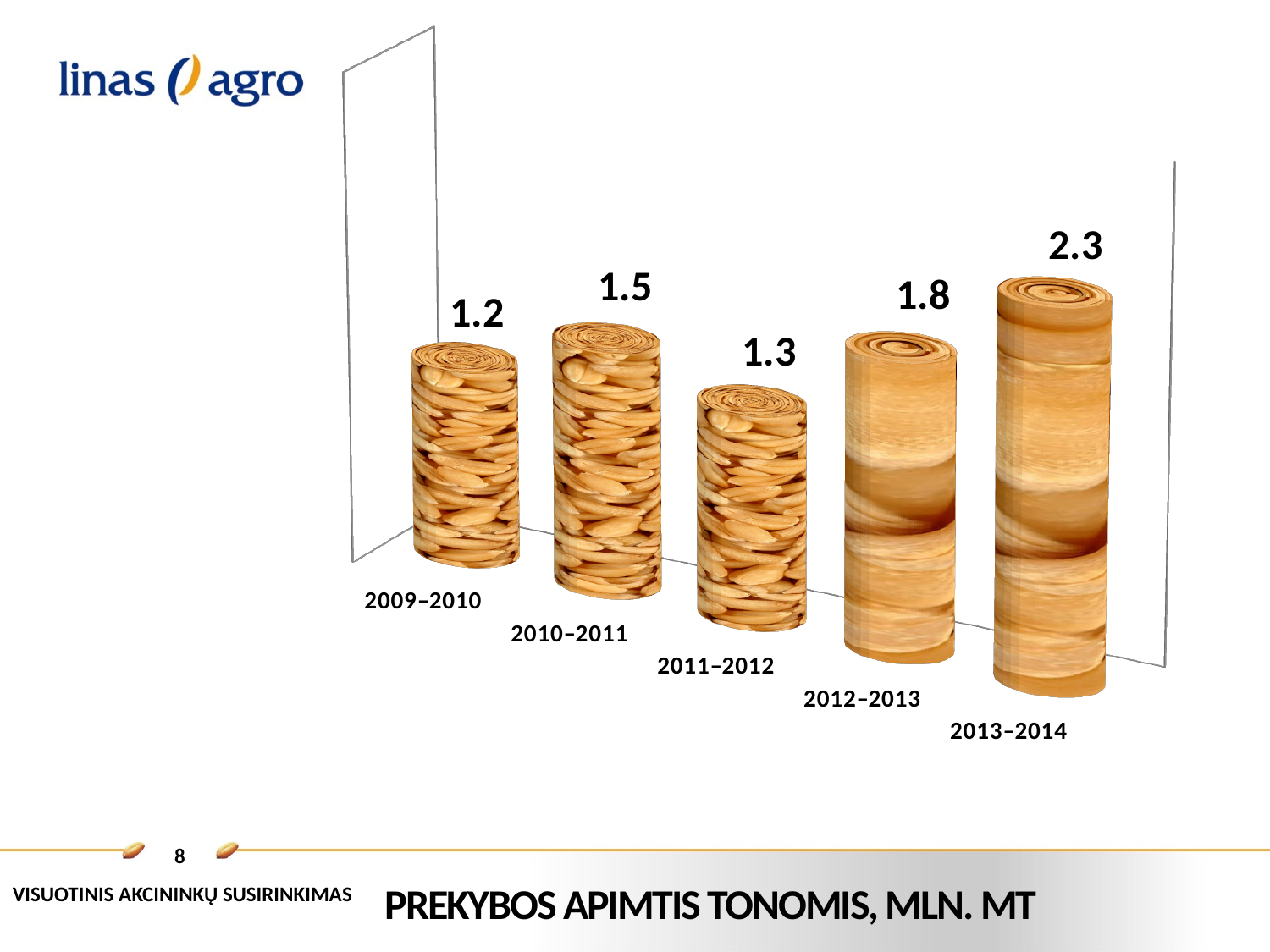
What is the value for 2011–2012? 1.3 Which period has the lowest value? 2009–2010 What is the difference between the values for 2010–2011 and 2011–2012? 0.2 Which period has the highest value? 2013–2014 What is the value for 2013–2014? 2.3 What is the value for 2012–2013? 1.8 What is the difference between the values for 2013–2014 and 2012–2013? 0.5 Which is larger, the value for 2010–2011 or the value for 2011–2012? 2010–2011 What is the value for 2009–2010? 1.2 What is the title of the chart shown at the bottom of the slide? PREKYBOS APIMTIS TONOMIS, MLN. MT What kind of chart is shown on the slide? bar chart How many periods are shown in the chart? 5